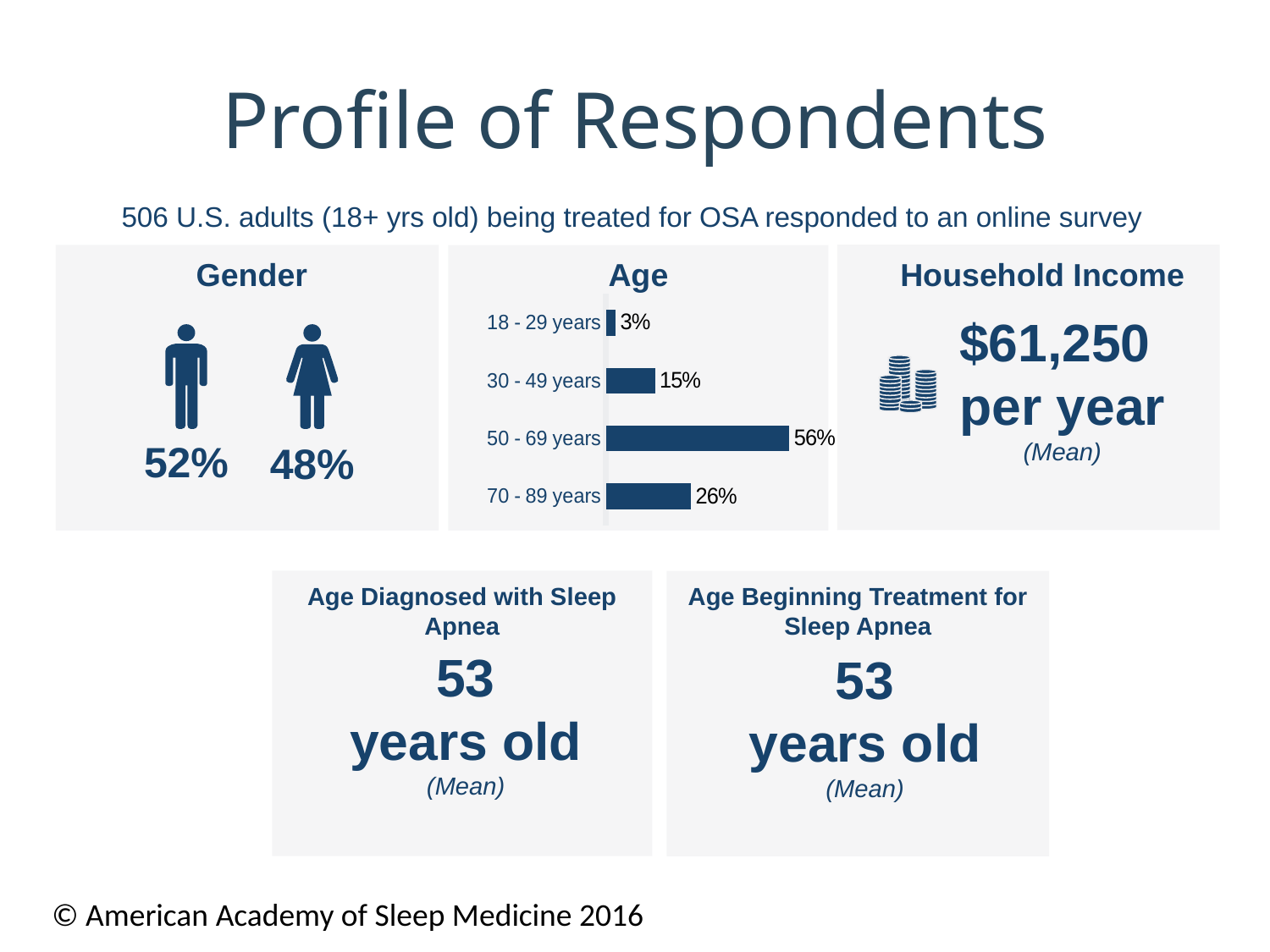
How many age groups are shown in the Age chart? 4 In the Age chart, what percentage of respondents are 18 - 29 years old? 3% In the Age chart, what is the combined percentage of respondents aged 18 - 29 years and 30 - 49 years? 18% In the Age chart, what percentage of respondents are 30 - 49 years old? 15% In the Age chart, what percentage of respondents are 50 - 69 years old? 56% What type of chart is the Age chart? Bar chart In the Age chart, what percentage of respondents are 70 - 89 years old? 26% In the Age chart, which age group has the lowest percentage of respondents? 18 - 29 years In the Age chart, which age group has the highest percentage of respondents? 50 - 69 years What is the title of the bar chart on the slide? Age In the Age chart, what is the difference in percentage points between the 50 - 69 years group and the 70 - 89 years group? 30 In the Age chart, which group has a larger share of respondents: 30 - 49 years or 70 - 89 years? 70 - 89 years